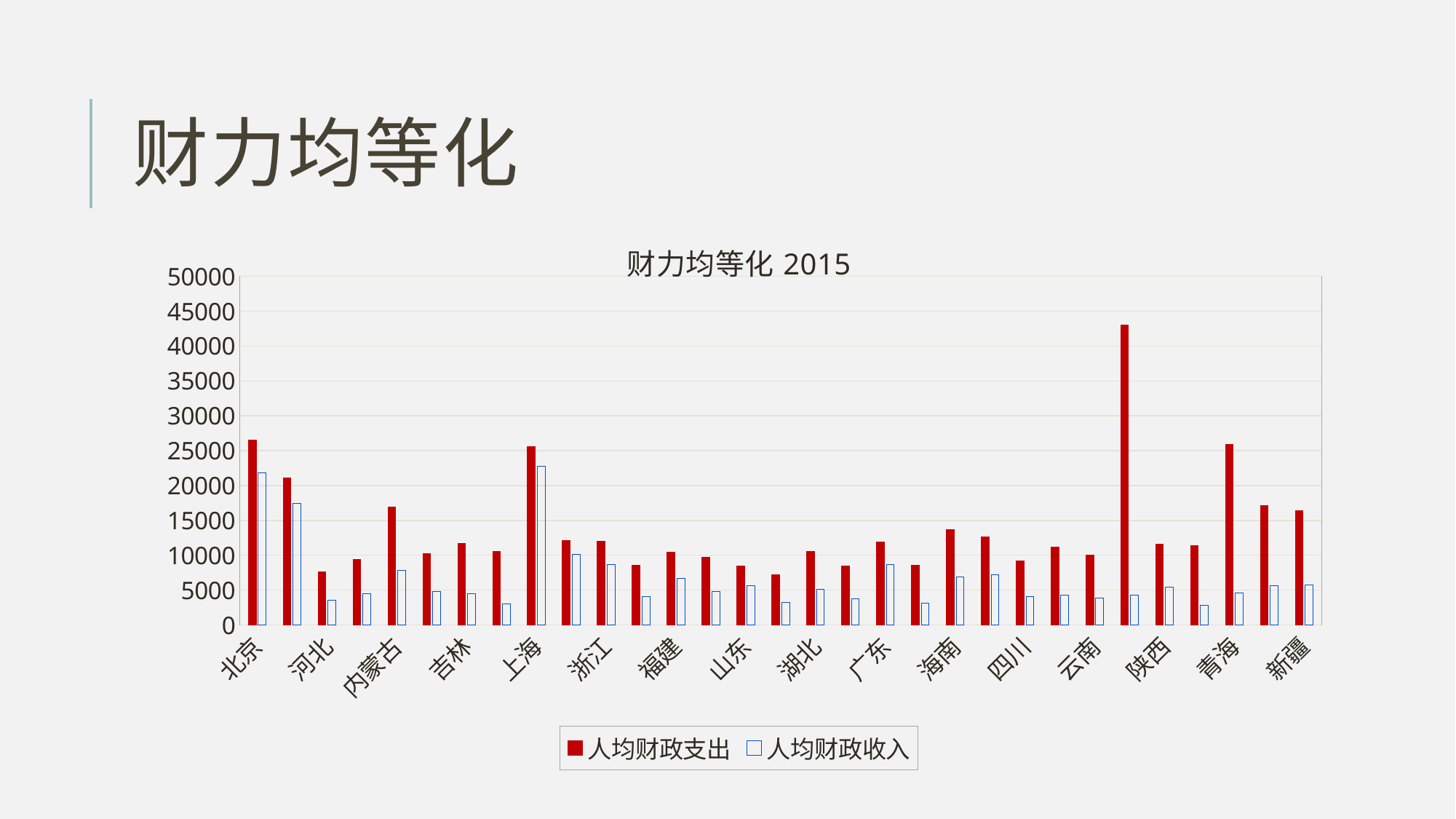
Which series is drawn in solid red bars? 人均财政支出 What is the title of the chart? 财力均等化 2015 Is the 人均财政支出 value for 河北 greater or less than 10000? less Is the 人均财政收入 value for 上海 greater or less than 20000? greater Is the 人均财政支出 value for 北京 greater or less than 25000? greater Which has the larger 人均财政支出 value, 北京 or 河北? 北京 What kind of chart is shown on the slide? bar chart How many series does the legend list? 2 Which has the larger 人均财政支出 value, 海南 or 山东? 海南 For 北京, which is larger, 人均财政支出 or 人均财政收入? 人均财政支出